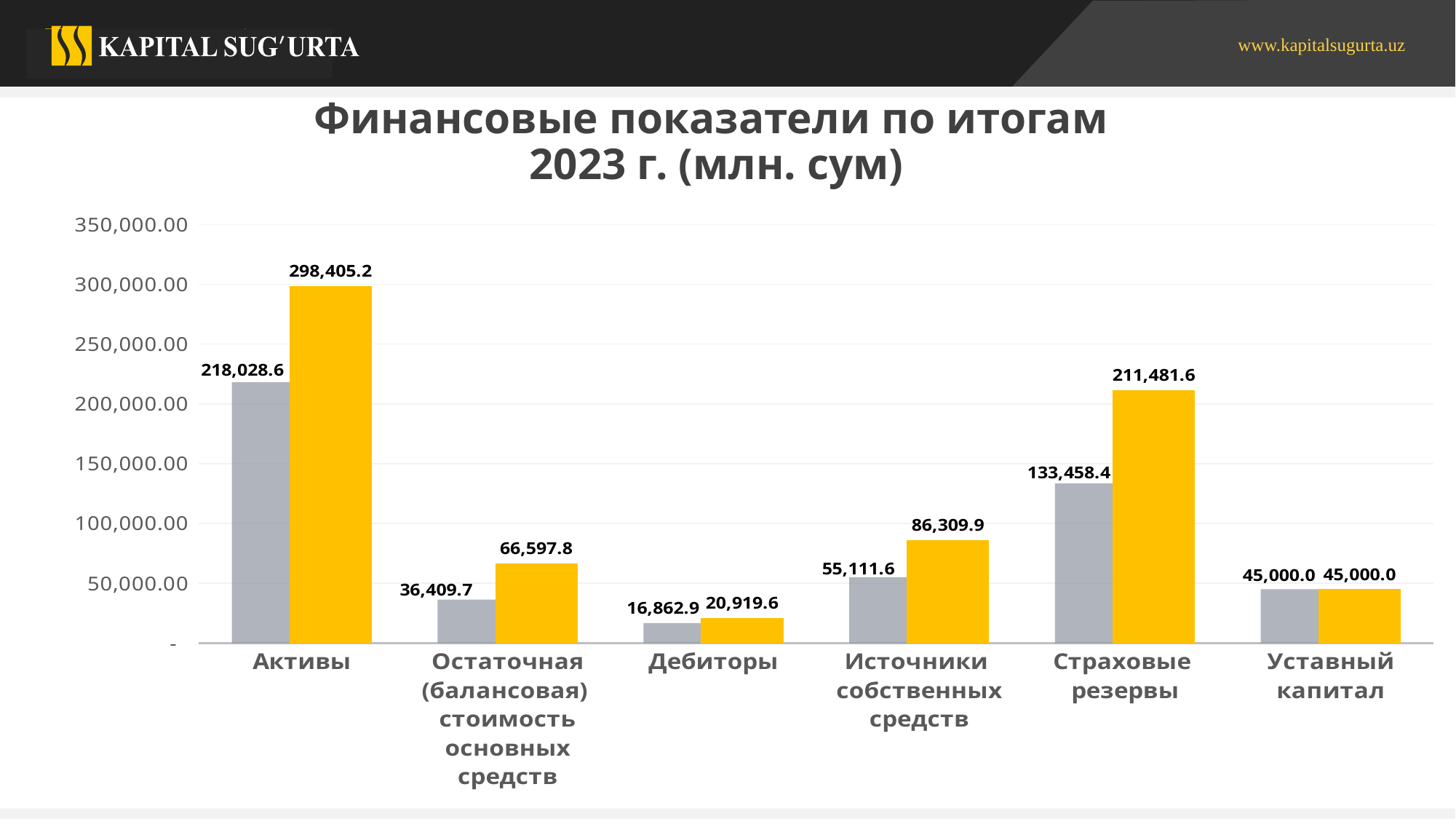
What is the value of the grey bar for Дебиторы? 16,862.9 What is the value of the yellow bar for Источники собственных средств? 86,309.9 What is the difference between the yellow and grey bars for Страховые резервы? 78,023.2 Which category has the lowest grey bar? Дебиторы Which is larger for Остаточная (балансовая) стоимость основных средств: the grey bar or the yellow bar? the yellow bar How many categories are shown on the x axis of the chart? 6 What is the title of the chart? Финансовые показатели по итогам 2023 г. (млн. сум) What is the difference between the yellow and grey bars for Активы? 80,376.6 What is the value of the yellow bar for Активы? 298,405.2 Which category has the highest yellow bar? Активы What is the value of the grey bar for Страховые резервы? 133,458.4 What type of chart is shown on the slide? bar chart